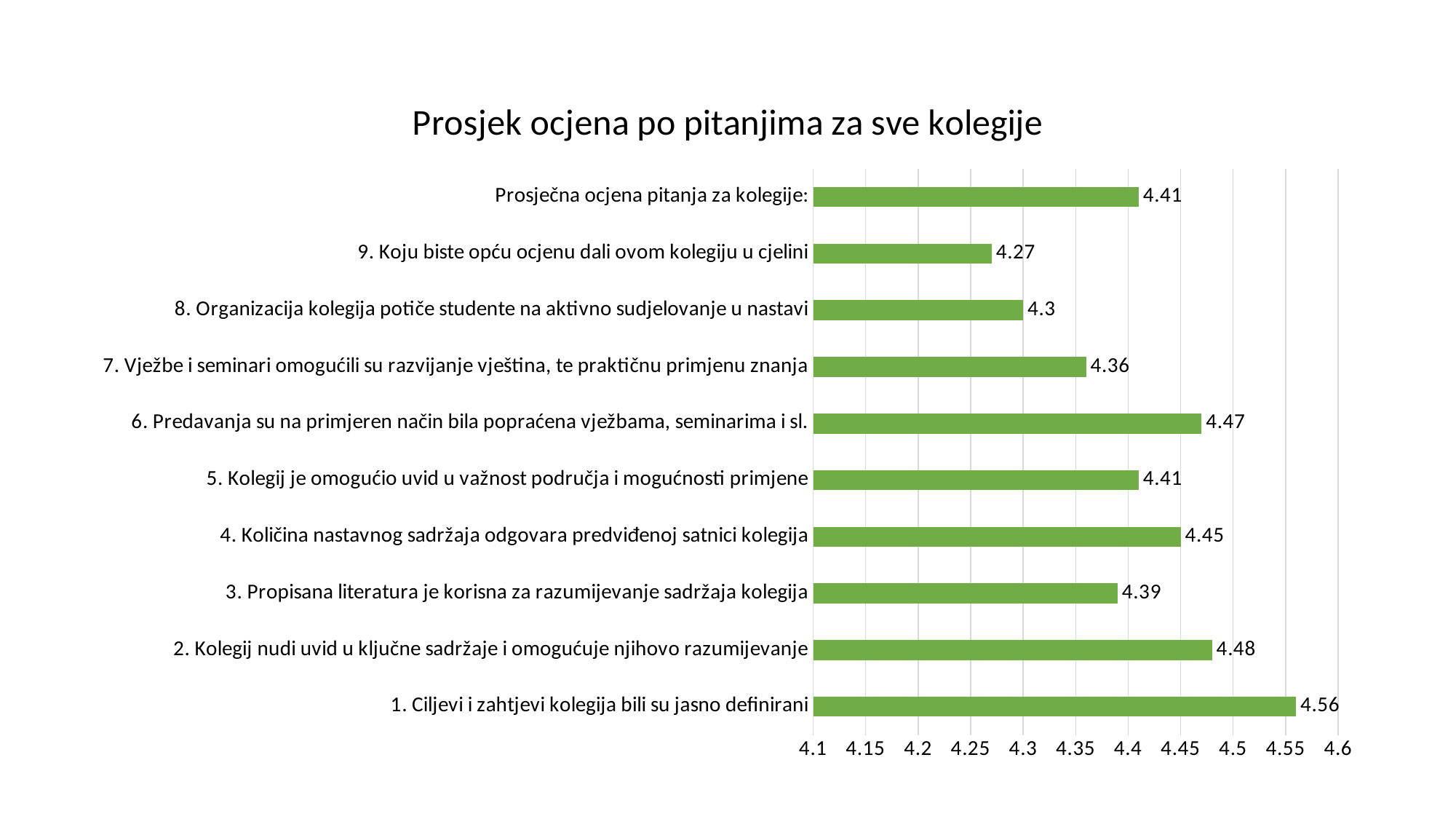
What is the title of the chart? Prosjek ocjena po pitanjima za sve kolegije What is the value for "1. Ciljevi i zahtjevi kolegija bili su jasno definirani"? 4.56 Which is larger: the value for "6. Predavanja su na primjeren način bila popraćena vježbama, seminarima i sl." or "7. Vježbe i seminari omogućili su razvijanje vještina, te praktičnu primjenu znanja"? 6. Predavanja su na primjeren način bila popraćena vježbama, seminarima i sl. What colour are the bars in the chart? green Which category has the highest value? 1. Ciljevi i zahtjevi kolegija bili su jasno definirani What is the value for "9. Koju biste opću ocjenu dali ovom kolegiju u cjelini"? 4.27 What kind of chart is shown on the slide? bar chart Which category has the lowest value? 9. Koju biste opću ocjenu dali ovom kolegiju u cjelini What is the value for "Prosječna ocjena pitanja za kolegije:"? 4.41 What is the difference between the values for "1. Ciljevi i zahtjevi kolegija bili su jasno definirani" and "9. Koju biste opću ocjenu dali ovom kolegiju u cjelini"? 0.29 Is the value for "8. Organizacija kolegija potiče studente na aktivno sudjelovanje u nastavi" greater or less than 4.4? less How many categories (bars) are shown in the chart? 10